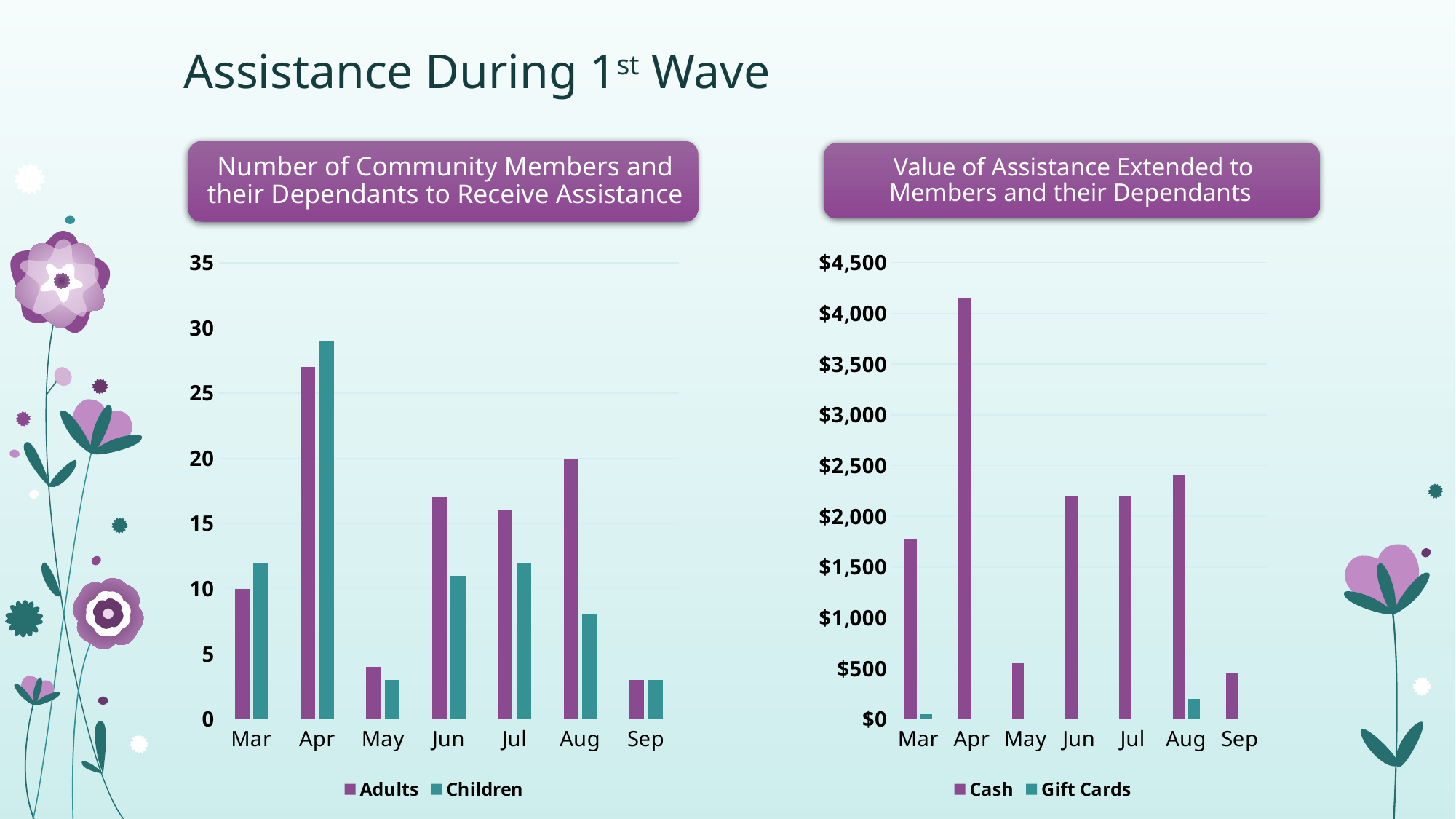
On the right chart (Value of Assistance Extended to Members and their Dependants), which month has the highest Cash value? Apr On the left chart (Number of Community Members and their Dependants to Receive Assistance), what is the Adults value for Aug? 20 On the right chart (Value of Assistance Extended to Members and their Dependants), which month has the larger Cash value, Jun or Aug? Aug On the left chart (Number of Community Members and their Dependants to Receive Assistance), is the Children value for Apr greater or less than 25? greater On the right chart (Value of Assistance Extended to Members and their Dependants), what are the two series listed in the legend? Cash and Gift Cards On the right chart (Value of Assistance Extended to Members and their Dependants), is the Cash value for Apr greater or less than $4,000? greater On the left chart (Number of Community Members and their Dependants to Receive Assistance), which is larger in Aug, Adults or Children? Adults On the left chart (Number of Community Members and their Dependants to Receive Assistance), which month has the highest Adults value? Apr On the left chart (Number of Community Members and their Dependants to Receive Assistance), how many series does the legend list? 2 On the left chart (Number of Community Members and their Dependants to Receive Assistance), how many months are shown on the x axis? 7 On the left chart (Number of Community Members and their Dependants to Receive Assistance), what kind of chart is shown? bar chart